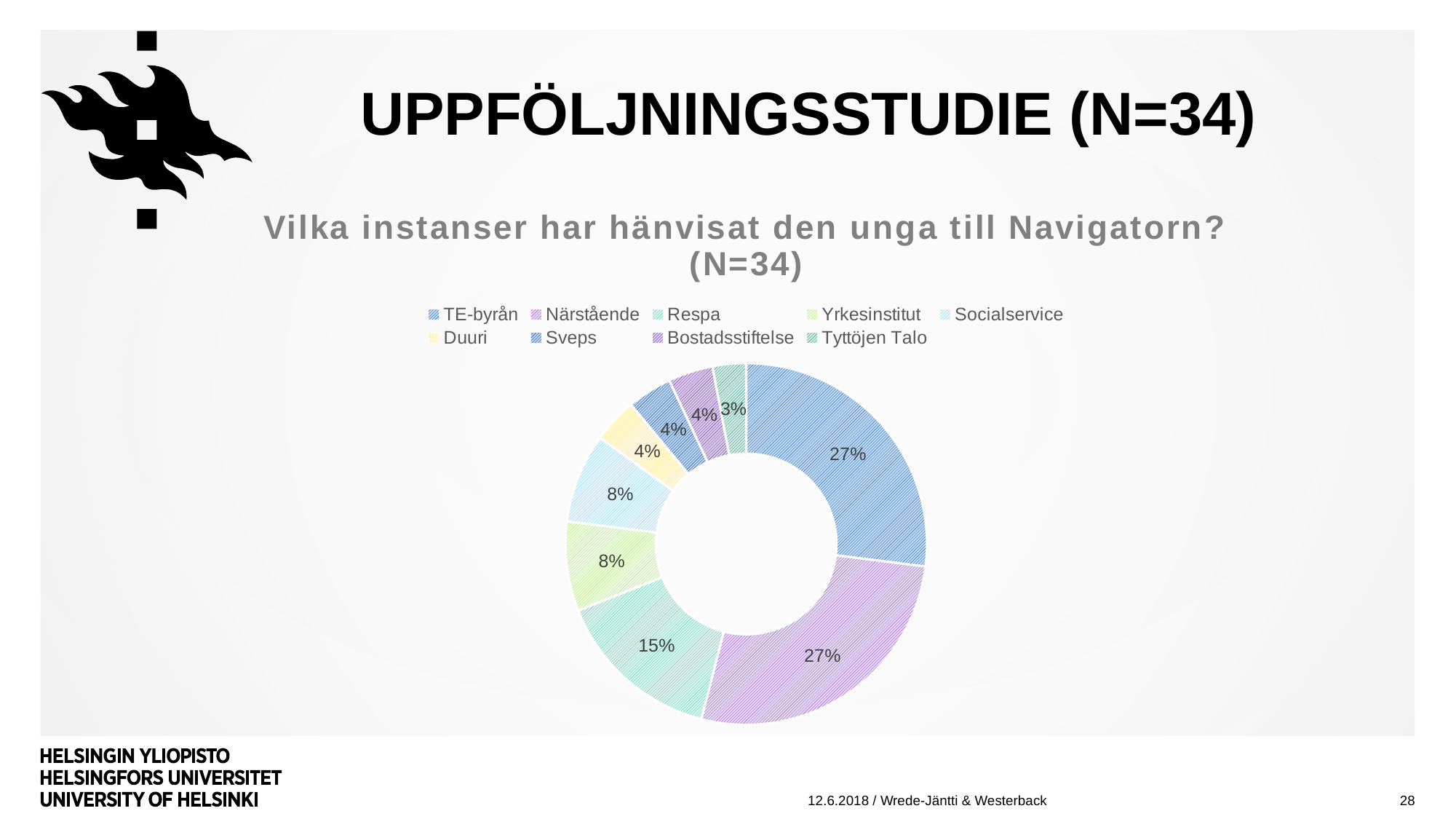
What percentage is shown for Yrkesinstitut? 8% What percentage is shown for Tyttöjen Talo? 3% What is the difference in percentage points between Socialservice and Duuri? 4 What is the difference in percentage points between Närstående and Respa? 12 What percentage is shown for Närstående? 27% How many categories does the chart's legend list? 9 What percentage is shown for TE-byrån? 27% What share of the chart does Respa account for? 15% What kind of chart is shown on the slide? Doughnut chart What is the title of the chart? Vilka instanser har hänvisat den unga till Navigatorn? (N=34) Which category has the smallest share in the chart? Tyttöjen Talo Which is larger, the share for Respa or the share for Socialservice? Respa